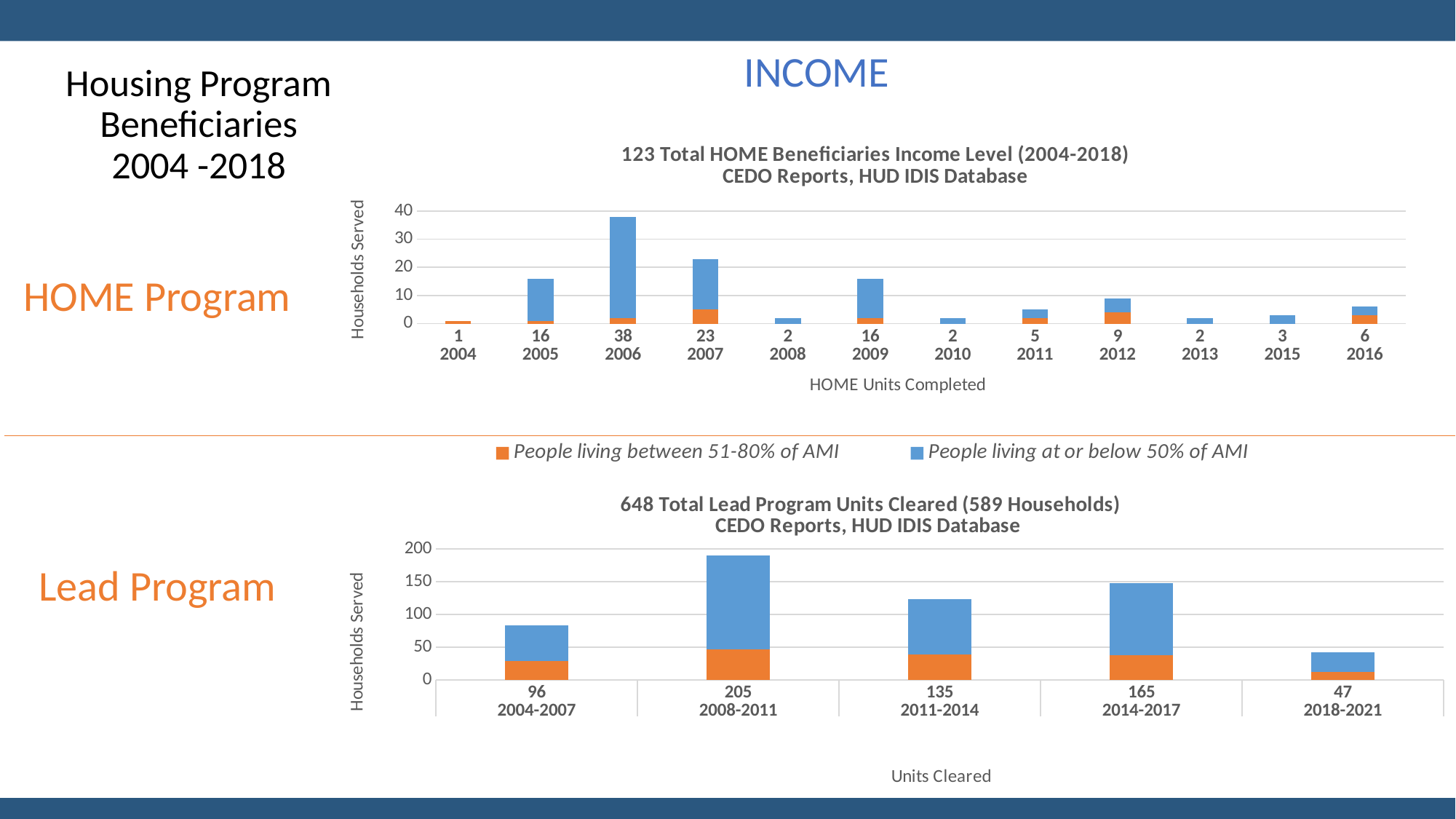
In the HOME Beneficiaries chart, how many HOME units completed are shown for 2007? 23 In the HOME Beneficiaries chart, how many HOME units completed are shown for 2006? 38 In the Lead Program chart, which period has the shortest bar for households served? 2018-2021 What type of chart is the '123 Total HOME Beneficiaries Income Level (2004-2018)' chart? bar chart In the Lead Program chart, how many units cleared are shown for 2014-2017? 165 In the Lead Program chart, which period has the tallest bar for households served? 2008-2011 In the Lead Program chart, is the households served bar for 2008-2011 greater or less than 150? greater How many series does the legend list for the charts on the slide? 2 In the Lead Program chart, what is the difference in units cleared between 2008-2011 and 2018-2021? 158 In the HOME Beneficiaries chart, is the households served bar for 2006 greater or less than 30? greater In the HOME Beneficiaries chart, which year has the tallest bar for households served? 2006 How many year categories are shown on the x axis of the HOME Beneficiaries chart? 12